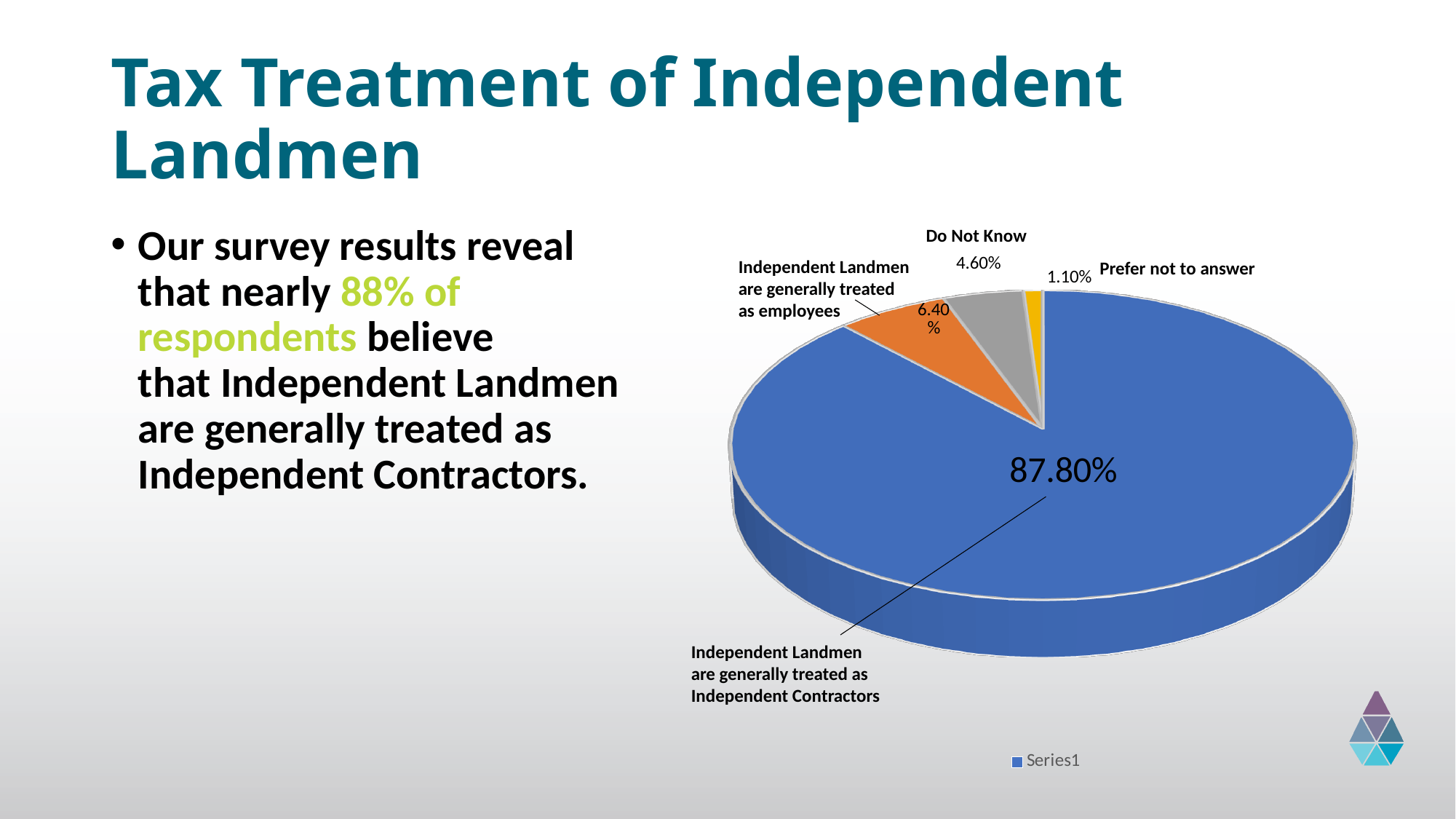
What kind of chart is shown on the slide? Pie chart How many slices does the pie chart have? 4 What series name is shown in the chart legend? Series1 What is the difference between the Do Not Know share and the Prefer not to answer share? 3.50% What share of respondents believe Independent Landmen are generally treated as Independent Contractors? 87.80% Which is larger: the share for 'generally treated as employees' or the share for 'Do Not Know'? Generally treated as employees What share of respondents believe Independent Landmen are generally treated as employees? 6.40% What share of respondents answered Do Not Know? 4.60% Which category has the smallest slice of the pie? Prefer not to answer What is the difference between the 'treated as Independent Contractors' share and the 'treated as employees' share? 81.40% What share of respondents chose Prefer not to answer? 1.10% Which category has the largest slice of the pie? Independent Landmen are generally treated as Independent Contractors